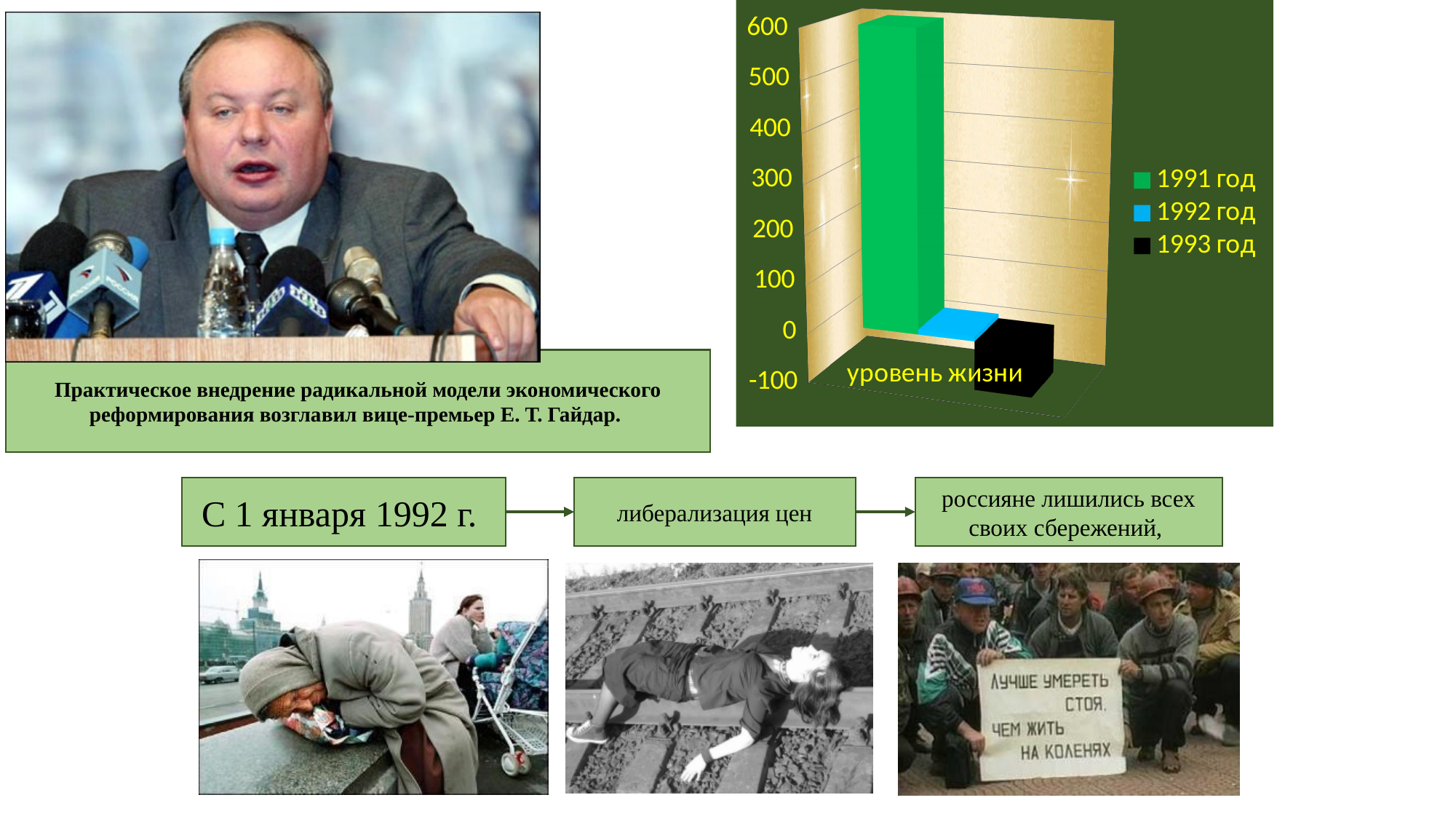
Do the values fall or rise from 1991 год to 1993 год? fall How many series does the chart's legend list? 3 Is the value for 1991 год greater or less than 500? greater Which is larger, the value for 1991 год or the value for 1992 год? 1991 год Is the value for 1992 год greater or less than 100? less Which series has the lowest value for уровень жизни? 1993 год What is the category label shown on the x axis of the chart? уровень жизни How many categories are plotted on the x axis of the chart? 1 What kind of chart is shown on the slide? bar chart What colour represents the series 1993 год in the chart's legend? black Is the value for 1993 год greater or less than 0? less Which series has the highest value for уровень жизни? 1991 год